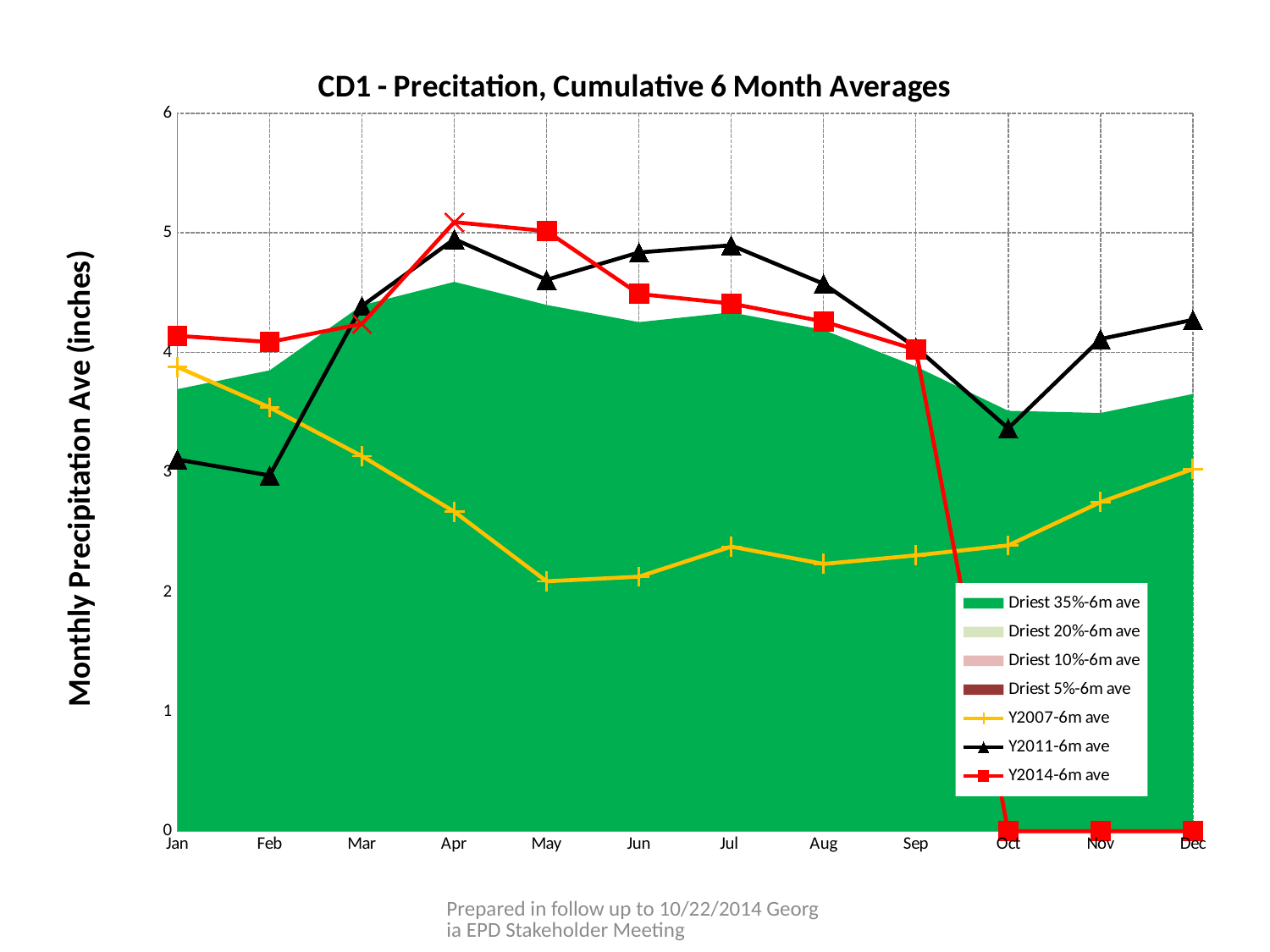
How many series does the legend list? 7 What kind of chart is this? combination area and line chart Is the Y2011-6m ave value for Apr greater or less than 4? greater What is the label of the y axis? Monthly Precipitation Ave (inches) Is the Y2007-6m ave value for May greater or less than 3? less What is the title of the chart? CD1 - Precitation, Cumulative 6 Month Averages In which month is the Y2011-6m ave series at its lowest? Feb In which month is the Y2007-6m ave series at its highest? Jan How many months are shown along the x axis? 12 Does the Y2007-6m ave series rise or fall from Jan to May? fall Is the Y2014-6m ave value for Oct greater or less than 1? less In Jan, which is higher: Y2014-6m ave or Y2011-6m ave? Y2014-6m ave